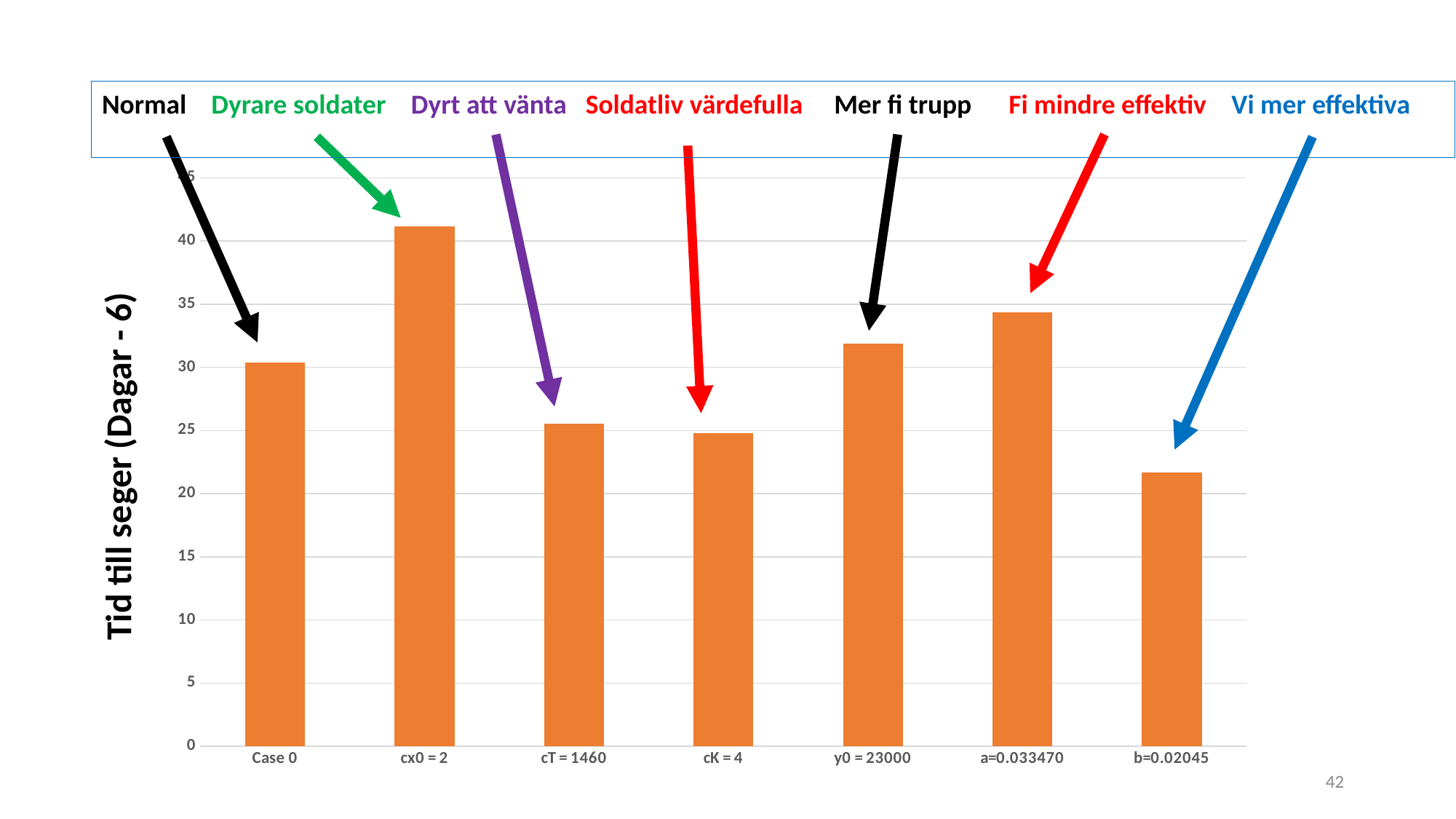
Which category has the lowest bar? b=0.02045 Is the value for a=0.033470 greater or less than 35? less Which is larger, the value for Case 0 or the value for a=0.033470? a=0.033470 How many categories (bars) are plotted in the chart? 7 What is the title of the vertical axis? Tid till seger (Dagar - 6) Is the value for cx0 = 2 greater or less than 40? greater Which is larger, the value for y0 = 23000 or the value for cT = 1460? y0 = 23000 Which category has the highest bar? cx0 = 2 What kind of chart is shown on the slide? bar chart Is the value for b=0.02045 greater or less than 25? less